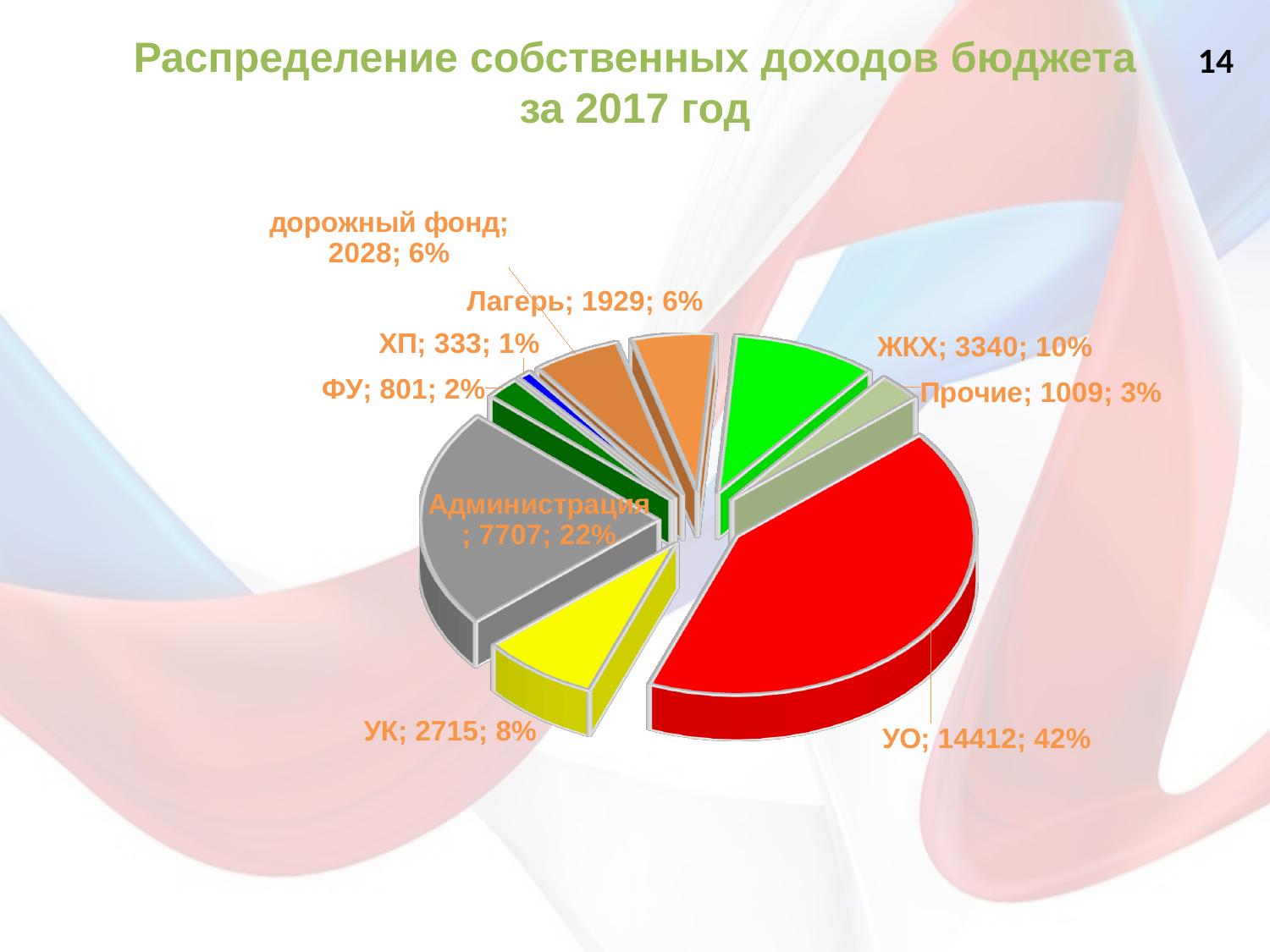
Which is larger, the value for УК or the value for дорожный фонд? УК What is the value for УО? 14412 What share of the pie does Прочие represent? 3% What is the value for Лагерь? 1929 What is the difference between the values for УО and Администрация? 6705 What is the value for ЖКХ? 3340 Which category has the largest slice of the pie? УО What kind of chart is shown on the slide? pie chart Which category has the smallest slice of the pie? ХП What is the title of the chart on the slide? Распределение собственных доходов бюджета за 2017 год How many categories are shown in the pie chart? 9 What share of the pie does Администрация represent? 22%